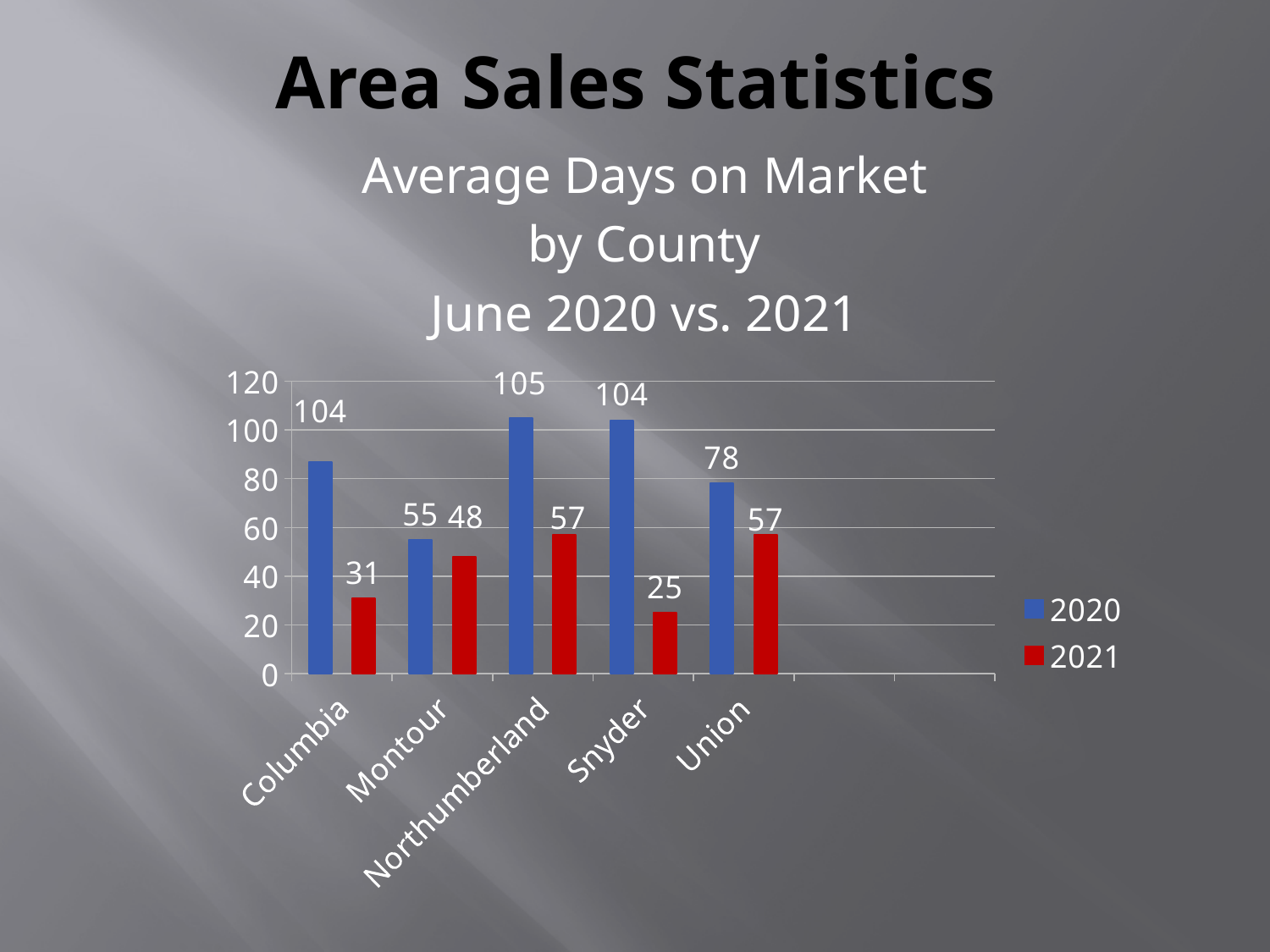
What is the 2021 value for Montour? 48 Which county has the lowest 2020 value? Montour What is the difference between the 2020 and 2021 values for Snyder? 79 How many series does the legend list? 2 What is the difference between the 2020 and 2021 values for Union? 21 What is the 2020 value for Union? 78 How many counties are shown on the x axis? 5 Which county has the lowest 2021 value? Snyder What is the 2020 value for Northumberland? 105 What is the 2021 value for Snyder? 25 Which is larger for Montour, the 2020 value or the 2021 value? 2020 What kind of chart is shown on the slide? Bar chart